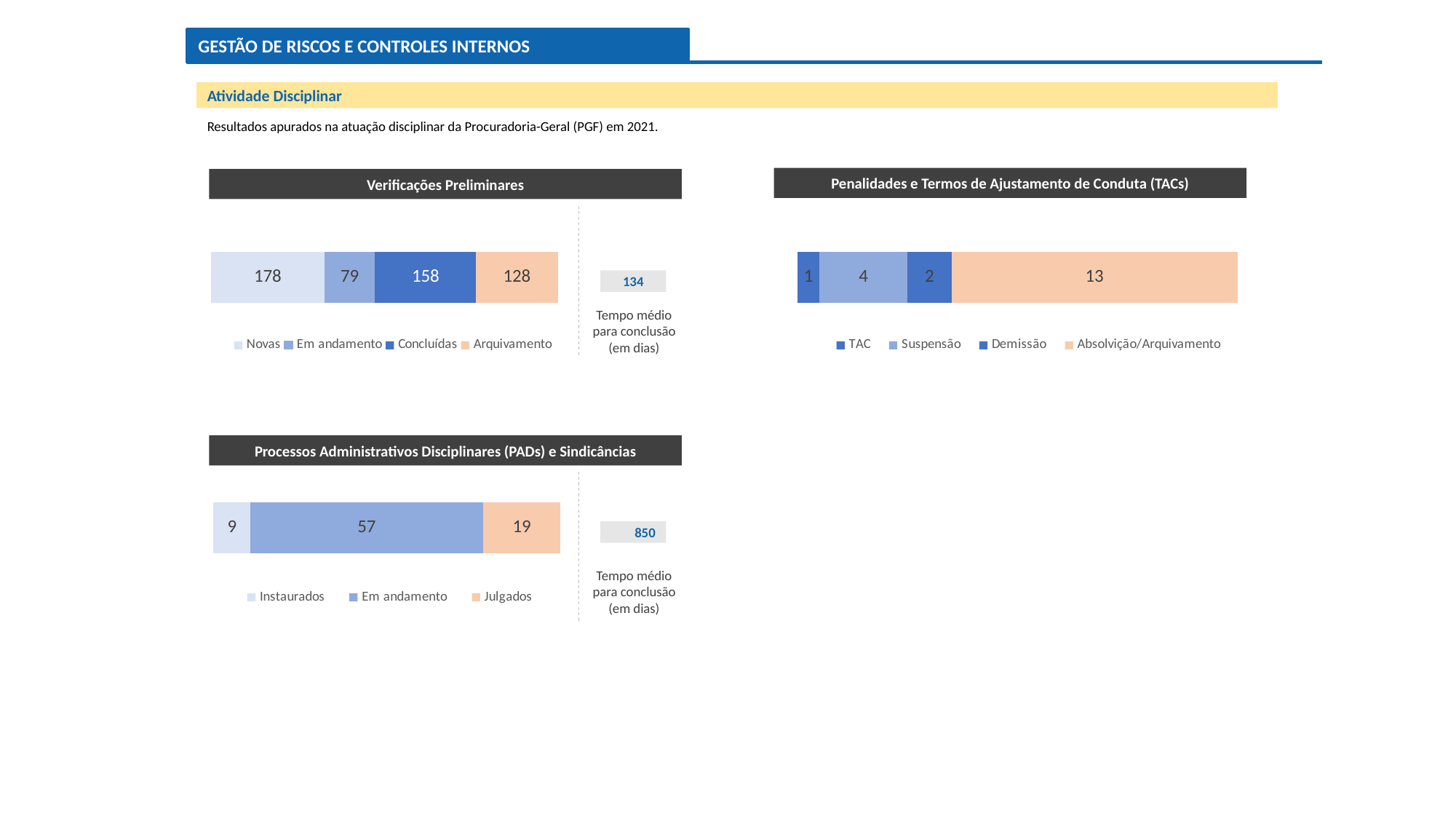
In the 'Penalidades e Termos de Ajustamento de Conduta (TACs)' chart, what is the total of the stacked bar? 20 In the 'Penalidades e Termos de Ajustamento de Conduta (TACs)' chart, what is the value for Suspensão? 4 In the 'Verificações Preliminares' chart, which segment has the lowest value? Em andamento In the 'Verificações Preliminares' chart, what is the value for Concluídas? 158 What kind of chart is the 'Verificações Preliminares' chart? Stacked bar chart In the 'Verificações Preliminares' chart, what is the difference between Novas and Arquivamento? 50 In the 'Processos Administrativos Disciplinares (PADs) e Sindicâncias' chart, what is the value for Em andamento? 57 In the 'Verificações Preliminares' chart, what is the value for Novas? 178 In the 'Verificações Preliminares' chart, what is the total of the stacked bar? 543 In the 'Processos Administrativos Disciplinares (PADs) e Sindicâncias' chart, which is larger, Instaurados or Julgados? Julgados In the 'Penalidades e Termos de Ajustamento de Conduta (TACs)' chart, which segment has the highest value? Absolvição/Arquivamento How many series does the legend of the 'Processos Administrativos Disciplinares (PADs) e Sindicâncias' chart list? 3